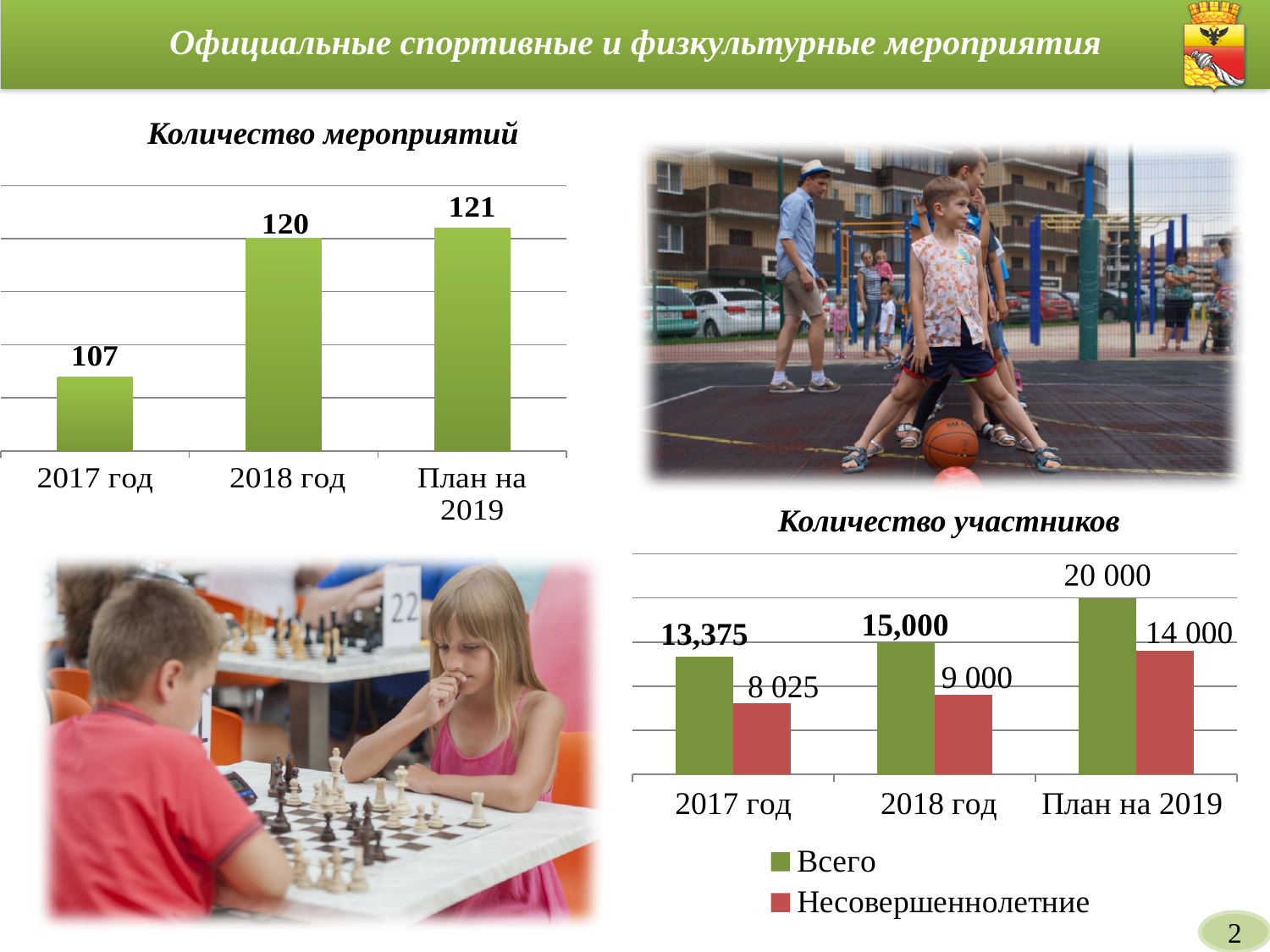
What kind of chart is 'Количество участников'? bar chart In the chart 'Количество мероприятий', how many categories are shown? 3 In the chart 'Количество участников', what is the value of Всего for 2017 год? 13,375 In the chart 'Количество мероприятий', which category has the lowest value? 2017 год In the chart 'Количество участников', what is the value of Всего for План на 2019? 20 000 In the chart 'Количество участников', which is larger for 2018 год: Всего or Несовершеннолетние? Всего In the chart 'Количество мероприятий', what is the difference between the values for 2018 год and 2017 год? 13 In the chart 'Количество мероприятий', what is the value for 2017 год? 107 In the chart 'Количество мероприятий', what is the value for 2018 год? 120 In the chart 'Количество участников', what is the value of Несовершеннолетние for 2017 год? 8 025 In the chart 'Количество мероприятий', do the values rise or fall from 2017 год to План на 2019? rise In the chart 'Количество участников', how many series does the legend list? 2